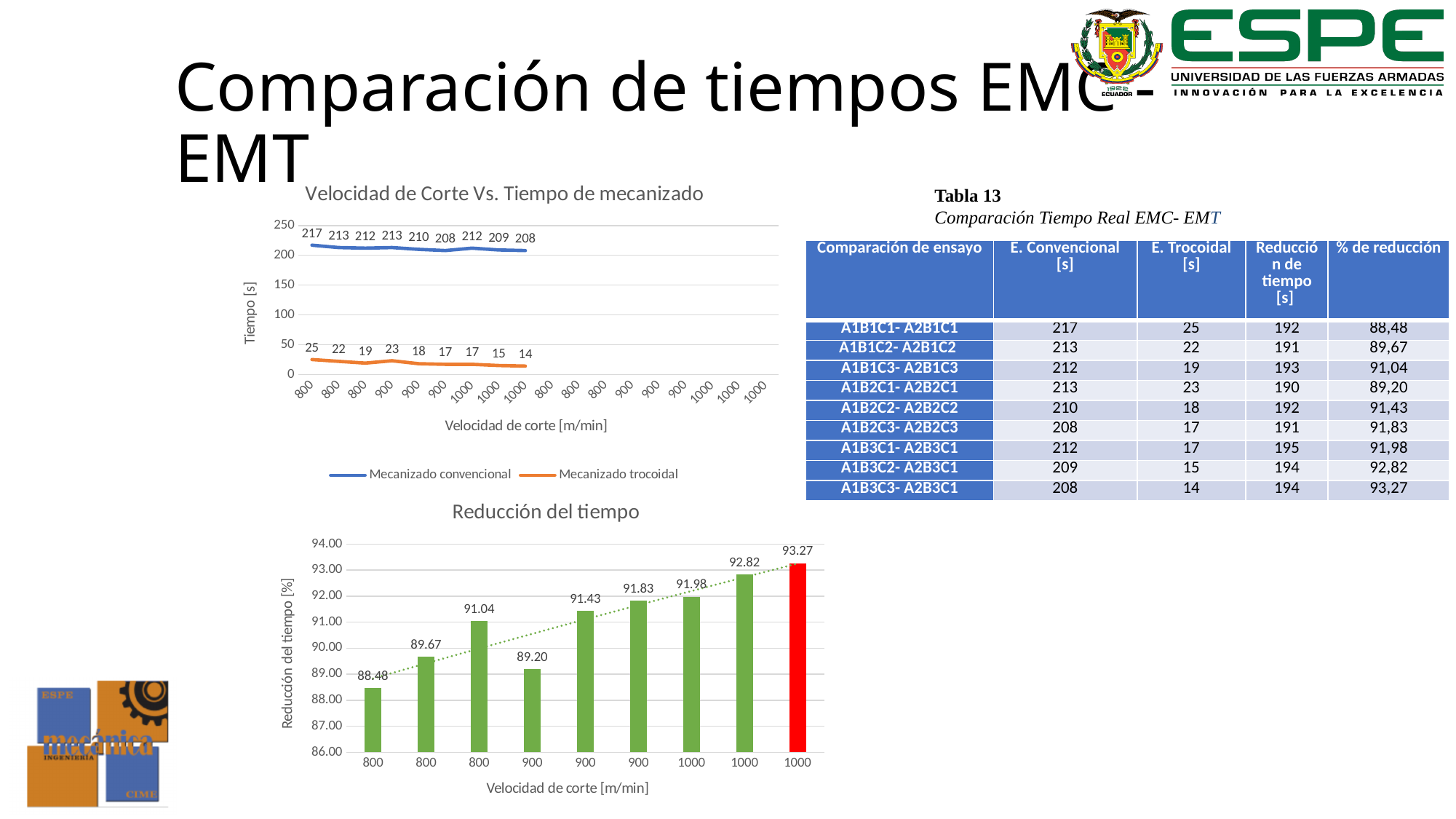
In the "Reducción del tiempo" chart, what is the difference between the highest and lowest values? 4.79 In the "Velocidad de Corte Vs. Tiempo de mecanizado" chart, what is the lowest value of the Mecanizado trocoidal series? 14 In the "Reducción del tiempo" chart, what colour is the last bar (the one with value 93.27)? red What kind of chart is the "Velocidad de Corte Vs. Tiempo de mecanizado" chart? line chart In the "Reducción del tiempo" chart, do the values generally rise or fall from left to right? rise What kind of chart is the "Reducción del tiempo" chart? bar chart In the "Velocidad de Corte Vs. Tiempo de mecanizado" chart, what is the first (leftmost) value of the Mecanizado convencional series? 217 How many bars are plotted in the "Reducción del tiempo" chart? 9 In the "Reducción del tiempo" chart, what is the highest value shown? 93.27 In the "Reducción del tiempo" chart, what is the lowest value shown? 88.48 In the "Velocidad de Corte Vs. Tiempo de mecanizado" chart, which series has the higher values, Mecanizado convencional or Mecanizado trocoidal? Mecanizado convencional How many series does the legend of the "Velocidad de Corte Vs. Tiempo de mecanizado" chart list? 2